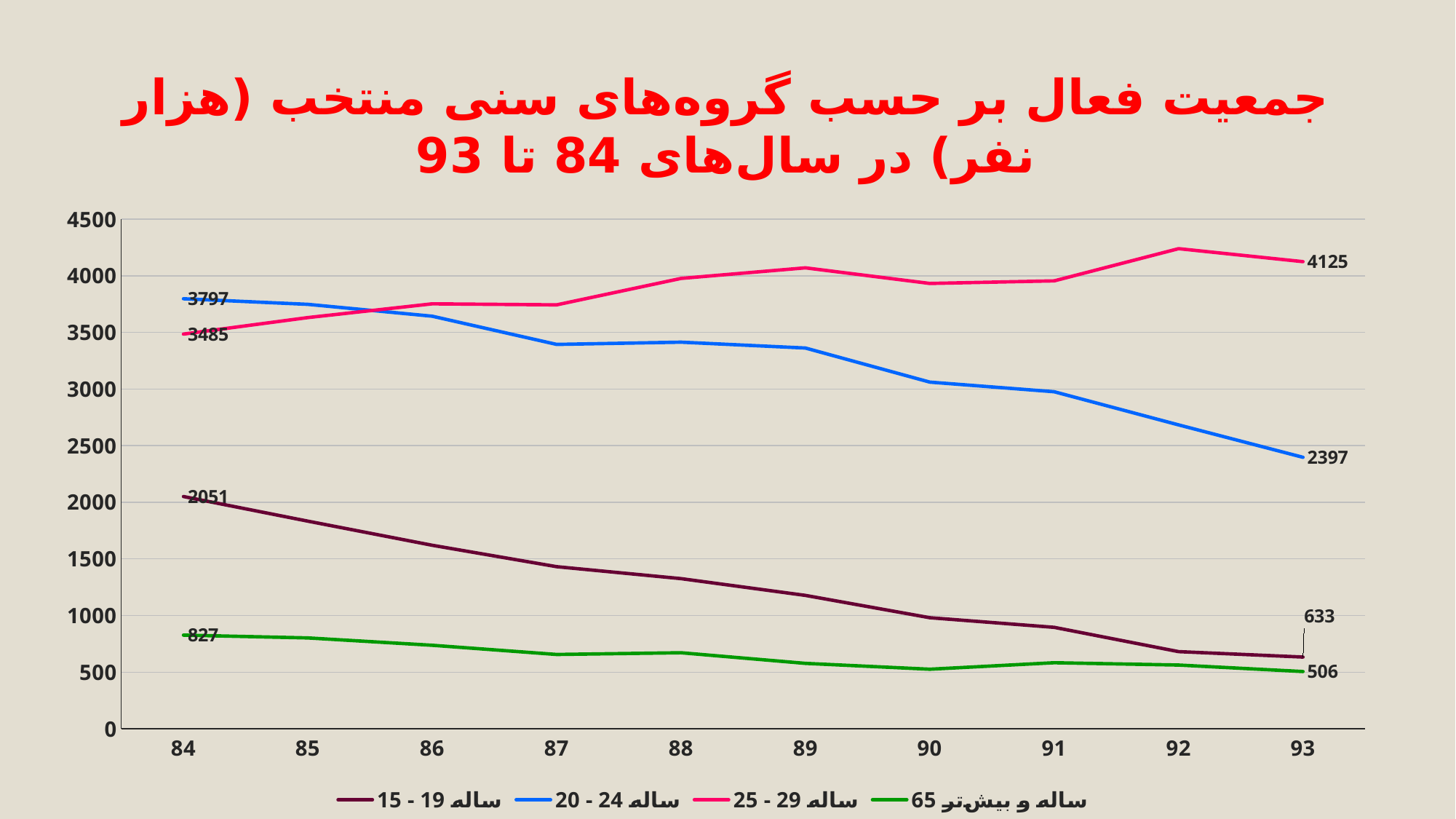
What is the difference between the 15 - 19 ساله values in year 84 and year 93? 1418 What is the value for the 25 - 29 ساله series in year 93? 4125 What is the value for the 65 ساله و بیشتر series in year 84? 827 Does the 20 - 24 ساله series rise or fall from year 84 to year 93? fall How many series does the legend list? 4 Which series has the lowest value in year 84? 65 ساله و بیشتر How many years are shown on the x axis? 10 Is the value for the 25 - 29 ساله series in year 89 greater or less than 4000? greater What kind of chart is shown on the slide? line chart Which series has the highest value in year 93? 25 - 29 ساله What is the value for the 20 - 24 ساله series in year 84? 3797 What is the value for the 15 - 19 ساله series in year 93? 633